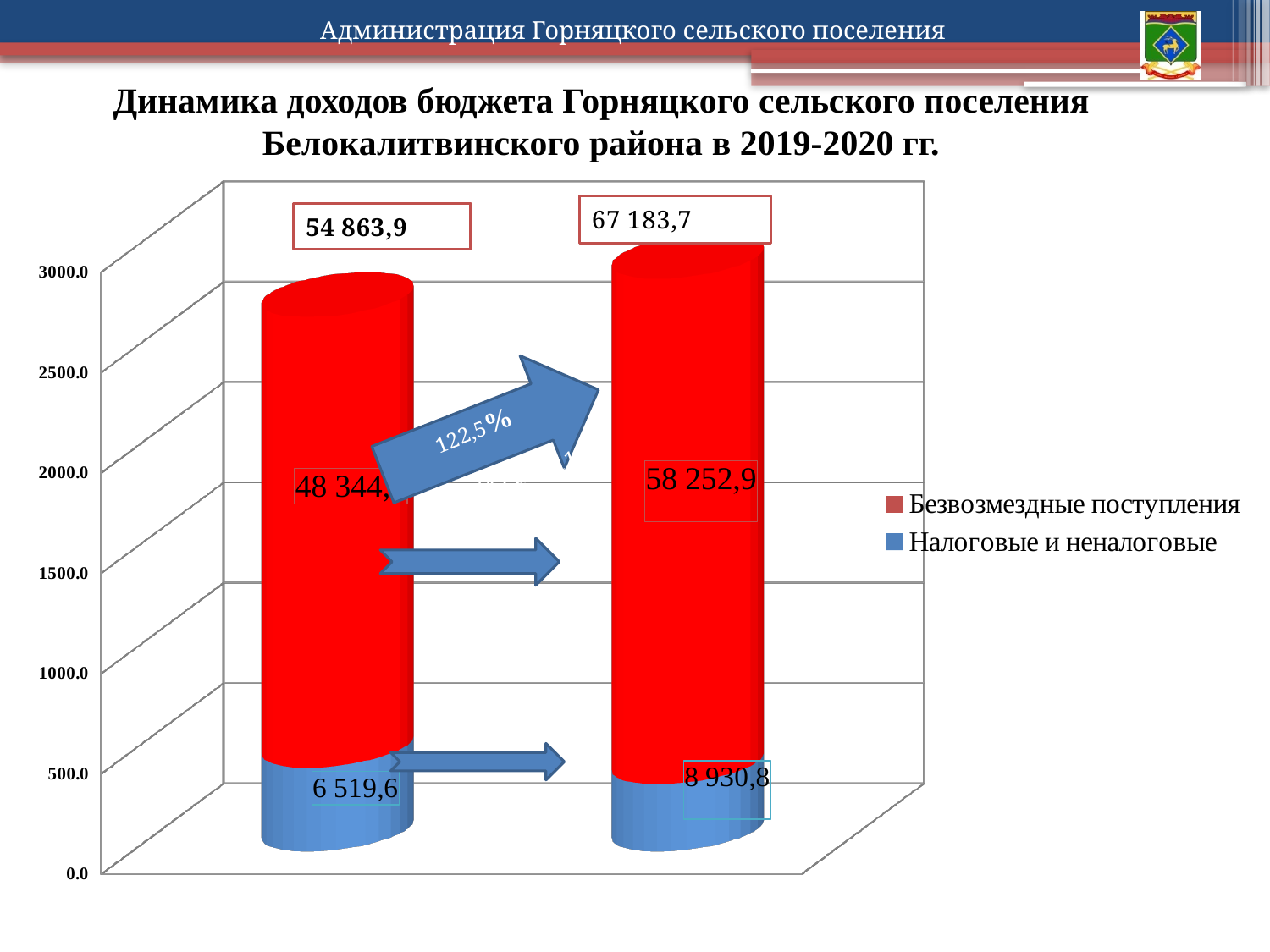
What is the value of the Безвозмездные поступления segment in the right bar? 58 252,9 What is the difference between the totals of the right bar and the left bar? 12 319,8 What percentage is written on the large arrow between the two bars? 122,5% What kind of chart is shown on the slide? bar chart What is the total shown above the right bar? 67 183,7 Which bar has the larger Налоговые и неналоговые value, the left or the right? right How many bars are plotted in the chart? 2 What is the value of the Налоговые и неналоговые segment in the left bar? 6 519,6 What is the total shown above the left bar? 54 863,9 By how much does the Налоговые и неналоговые value in the right bar exceed that in the left bar? 2 411,2 What is the value of the Налоговые и неналоговые segment in the right bar? 8 930,8 How many series does the legend list? 2